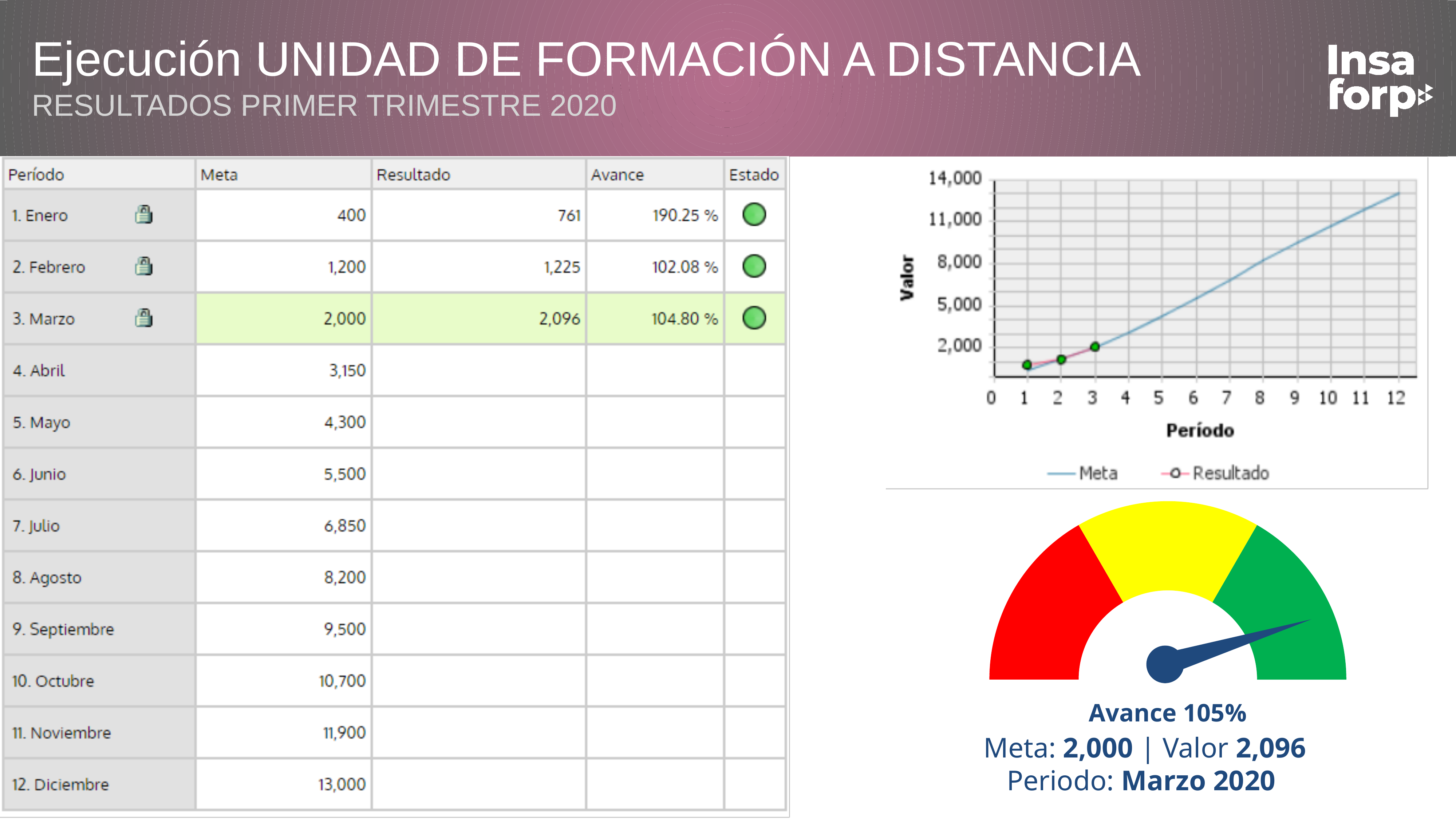
How many series does the legend of the line chart list? 2 What are the two series named in the legend of the line chart? Meta and Resultado In the line chart, is the Meta value at period 1 greater or less than 2,000? less What Avance percentage is shown below the gauge chart? 105% Below the gauge chart, what is the difference between the Valor (2,096) and the Meta (2,000)? 96 In the line chart, is the Meta value at period 9 greater or less than 8,000? greater In the line chart, does the Meta line rise or fall as the period increases from 0 to 12? rise What Valor is shown below the gauge chart? 2,096 In which coloured zone does the needle of the gauge chart point? green In the line chart, how many Resultado data points are plotted? 3 In the line chart, is the Meta value at period 12 greater or less than 11,000? greater What kind of chart is the upper chart on the right of the slide? line chart